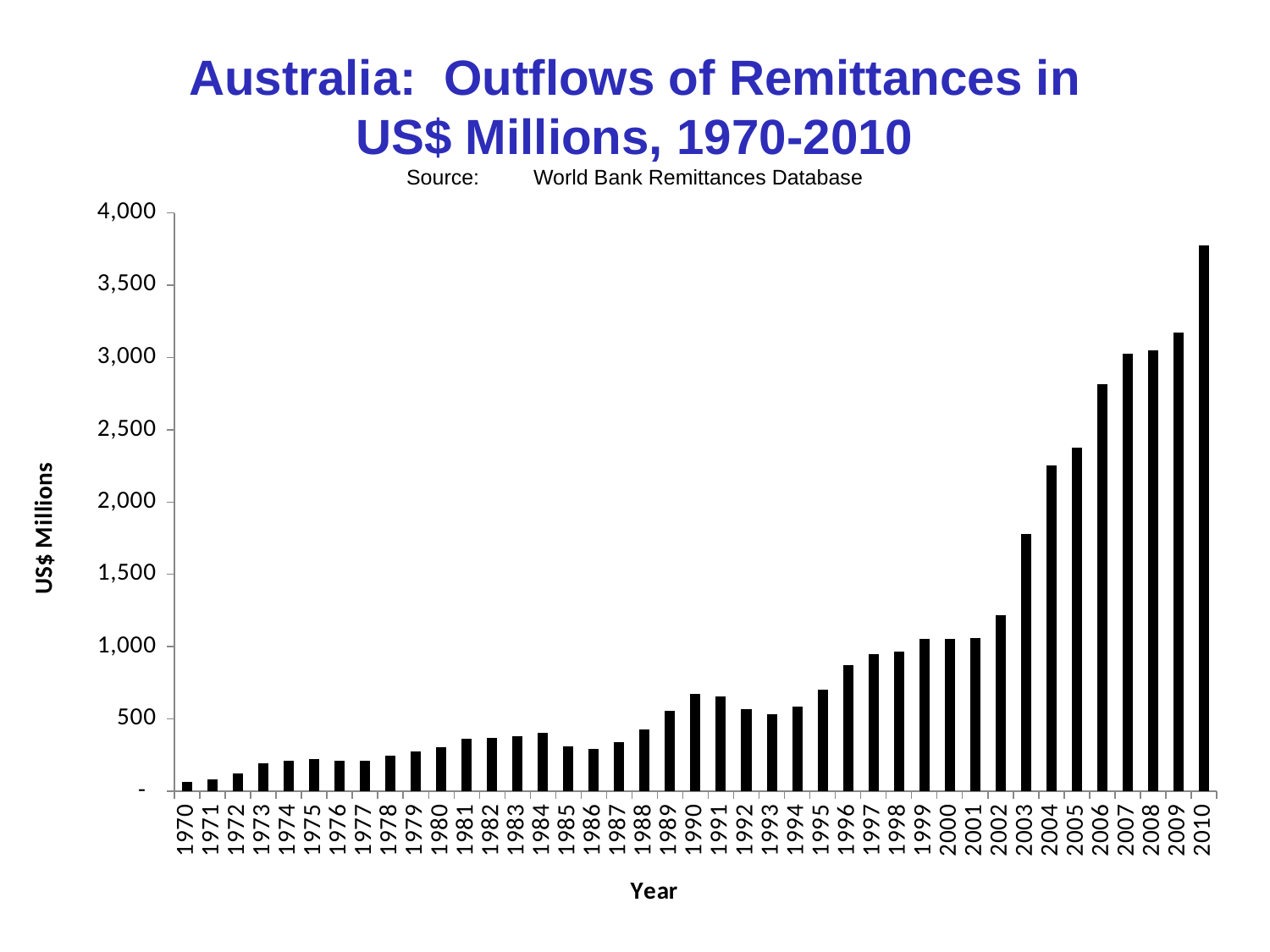
Which year has the larger outflow, 1985 or 1990? 1990 Which year has the highest outflow of remittances? 2010 Is the value for 1985 greater or less than 500? less Do the remittance outflows generally rise or fall from 1970 to 2010? rise Is the value for 2010 greater or less than 3,500? greater Which year has the lowest outflow of remittances? 1970 Is the value for 2003 greater or less than 1,500? greater What is the label on the vertical axis? US$ Millions What kind of chart is shown on the slide? bar chart How many years (bars) are plotted on the chart? 41 Which year has the larger outflow, 2003 or 2004? 2004